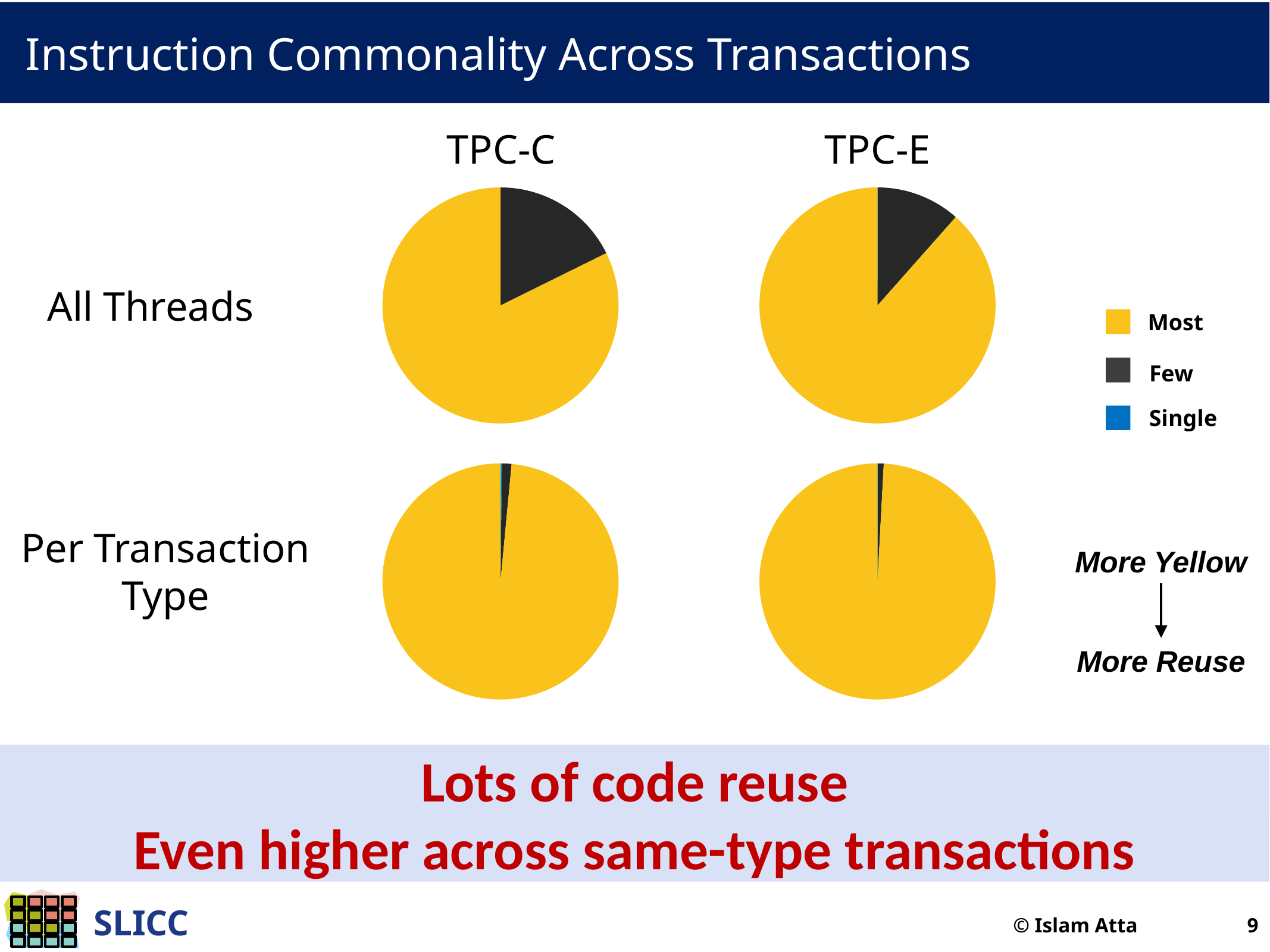
Which colour represents the Most category in the legend? Yellow In the All Threads TPC-C pie chart, which category has the largest slice? Most In the All Threads TPC-E pie chart, which category has the largest slice? Most Which colour represents the Few category in the legend? Dark grey Comparing the All Threads pie charts, is the Few slice larger for TPC-C or TPC-E? TPC-C In the Per Transaction Type TPC-C pie chart, which category has the largest slice? Most What kind of charts are shown on the slide? Pie charts How many categories does the legend list? 3 How many pie charts are on the slide? 4 Is the Few slice larger in the All Threads TPC-C pie chart or the Per Transaction Type TPC-C pie chart? All Threads TPC-C